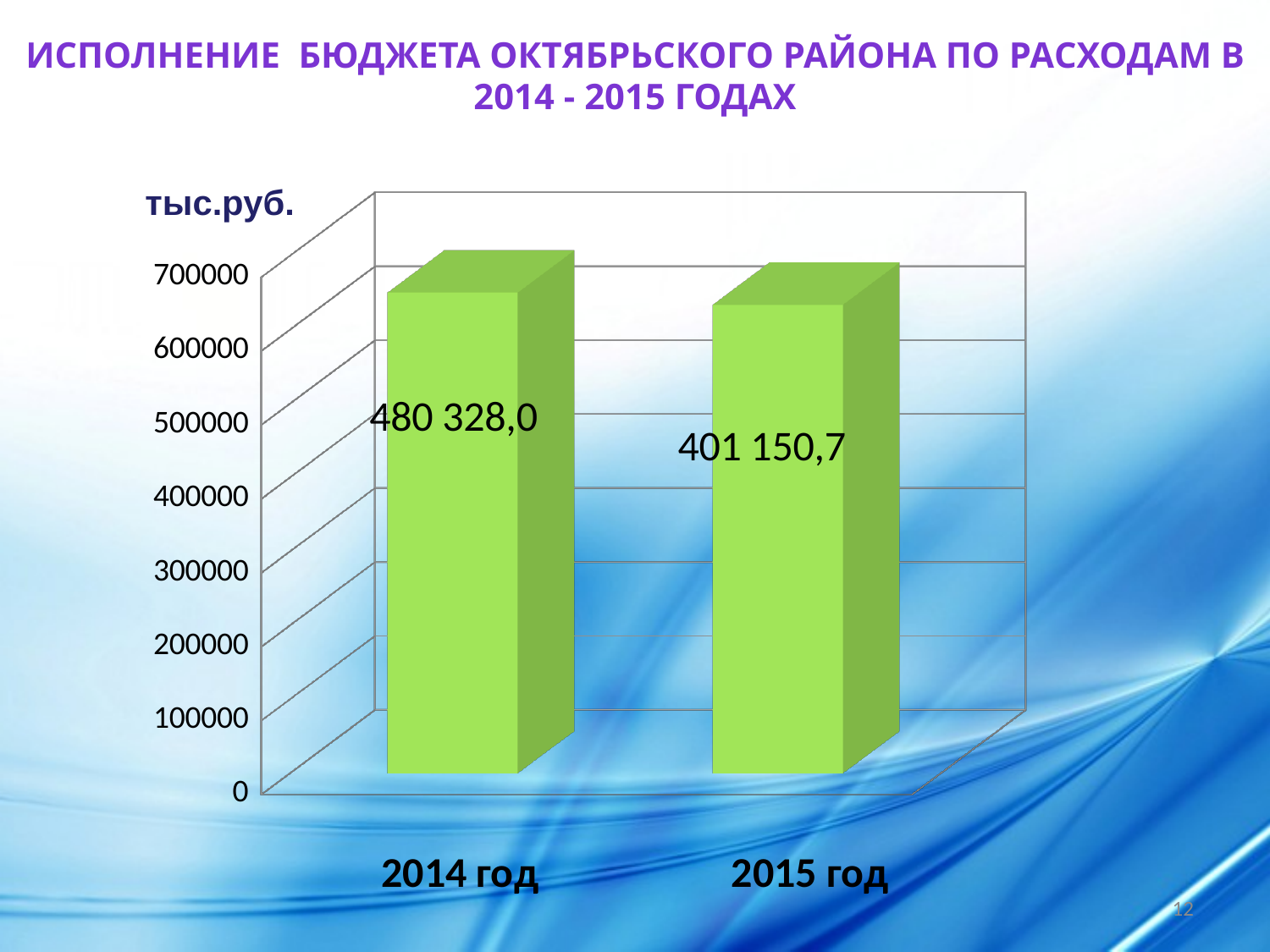
Which year has the lowest value? 2015 год What is the difference between the values for 2014 год and 2015 год? 79 177,3 Which is larger, the value for 2014 год or the value for 2015 год? 2014 год Do the values rise or fall from 2014 год to 2015 год? fall What kind of chart is shown on the slide? bar chart Which year has the highest value? 2014 год What unit is shown above the vertical axis of the chart? тыс.руб. Is the value for 2015 год greater or less than 400000? greater What colour are the bars in the chart? green How many categories are shown on the x axis? 2 What is the value for 2014 год? 480 328,0 What is the value for 2015 год? 401 150,7